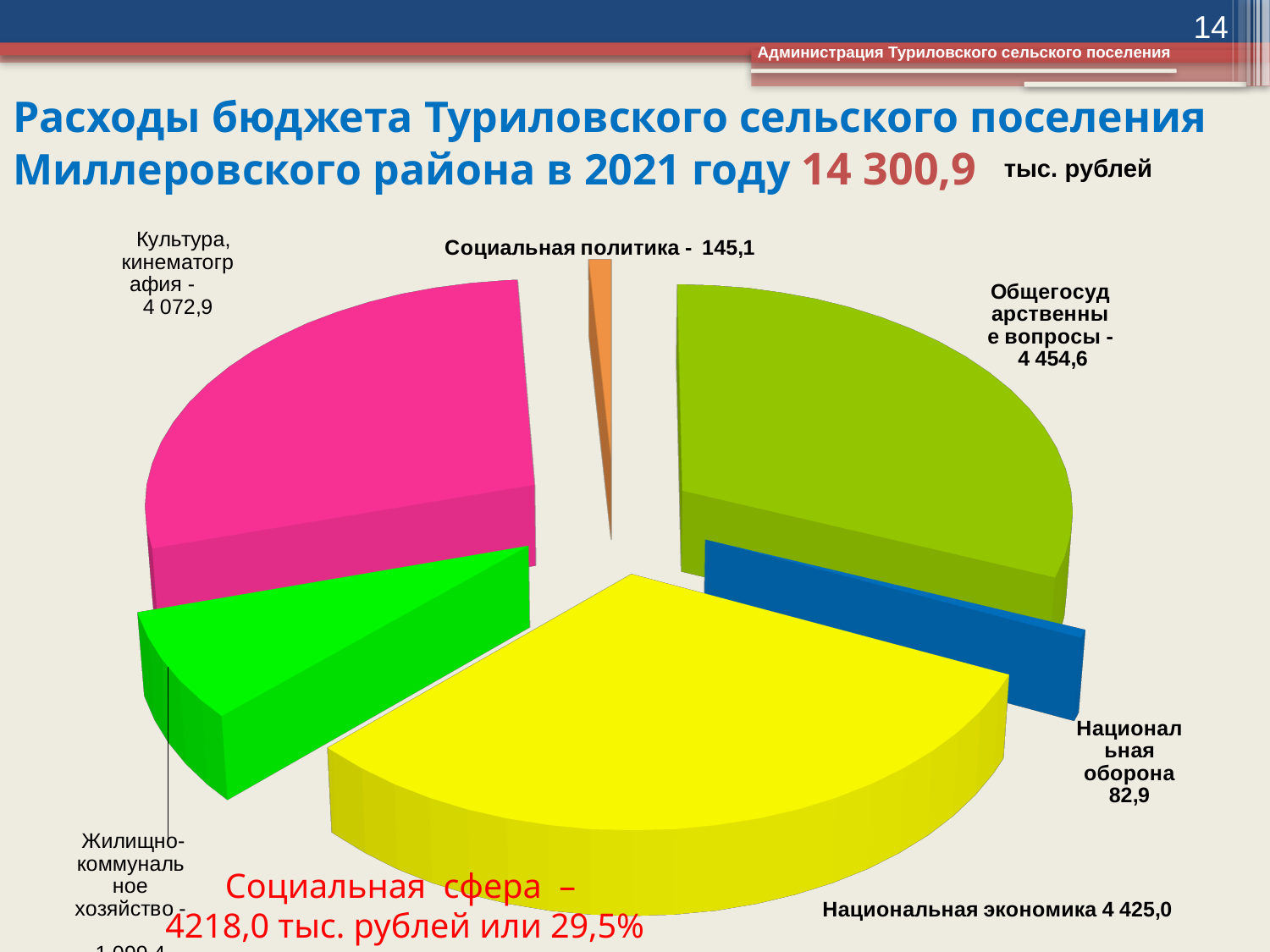
Which category has the largest value in the pie chart? Общегосударственные вопросы What is the value for Общегосударственные вопросы? 4 454,6 What is the difference between Общегосударственные вопросы and Культура, кинематография? 381,7 Which is larger: Социальная политика or Национальная оборона? Социальная политика What is the value for Социальная политика? 145,1 What kind of chart is shown on the slide? pie chart What is the value for Национальная экономика? 4 425,0 What is the value for Культура, кинематография? 4 072,9 What is the value for Национальная оборона? 82,9 How many slices does the pie chart have? 6 Which category has the smallest value in the pie chart? Национальная оборона What is the total budget expenditure shown in the slide title? 14 300,9 тыс. рублей